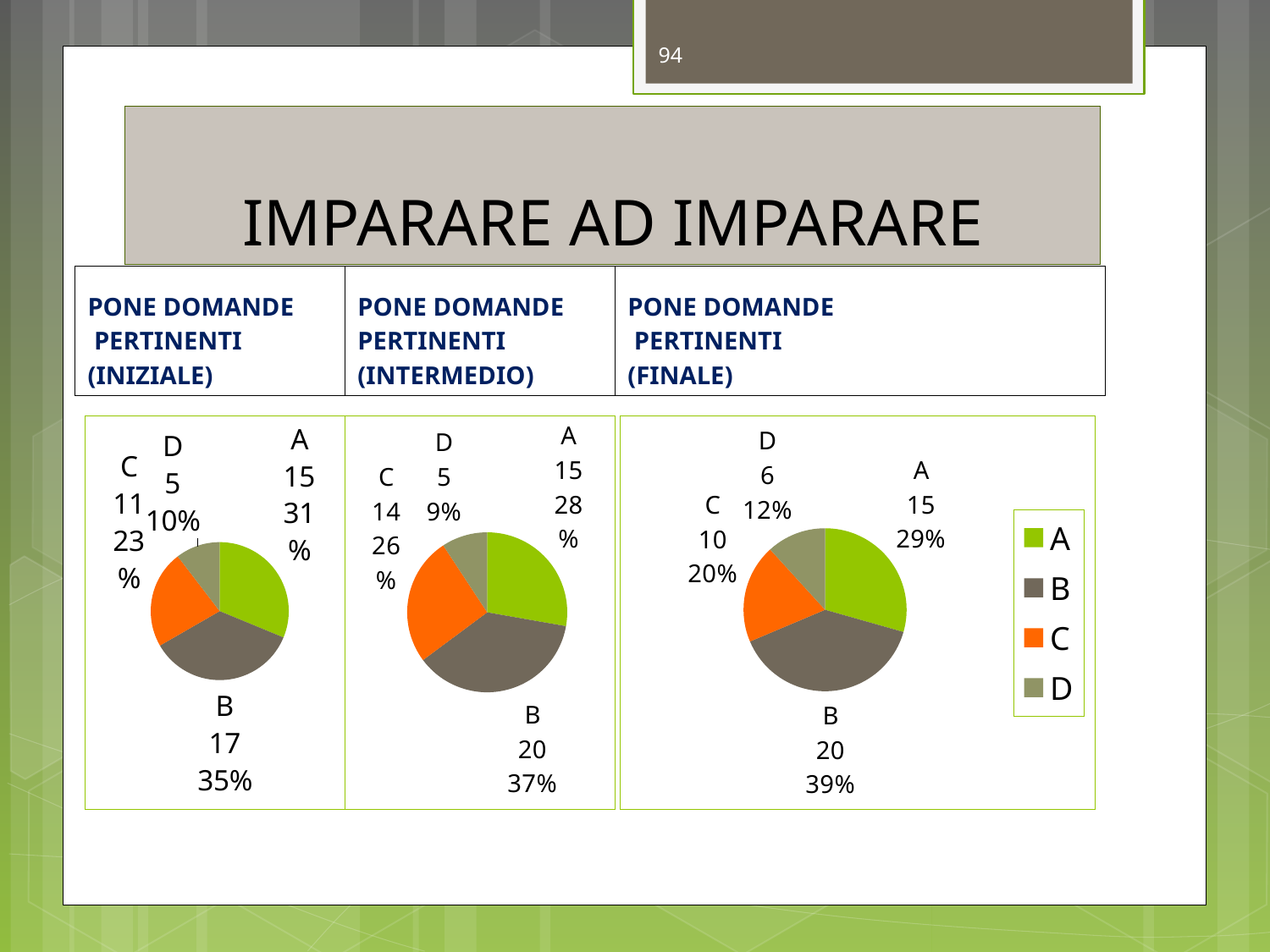
In the PONE DOMANDE PERTINENTI (FINALE) chart, which category has the largest slice? B In the PONE DOMANDE PERTINENTI (INTERMEDIO) chart, what is the value for category C? 14 In the PONE DOMANDE PERTINENTI (FINALE) chart, what is the value for category D? 6 In the PONE DOMANDE PERTINENTI (INTERMEDIO) chart, what is the difference between the values for B and A? 5 In the PONE DOMANDE PERTINENTI (INIZIALE) chart, what is the value for category B? 17 In the PONE DOMANDE PERTINENTI (FINALE) chart, what percentage share does category B have? 39% In the PONE DOMANDE PERTINENTI (INIZIALE) chart, which category has the smallest slice? D How many categories does the legend on the slide list? 4 What kind of chart is used for PONE DOMANDE PERTINENTI (INTERMEDIO)? Pie chart In the PONE DOMANDE PERTINENTI (INIZIALE) chart, what percentage share does category C have? 23% In the PONE DOMANDE PERTINENTI (FINALE) chart, which is larger, the value for C or the value for D? C In the PONE DOMANDE PERTINENTI (INTERMEDIO) chart, what percentage share does category D have? 9%